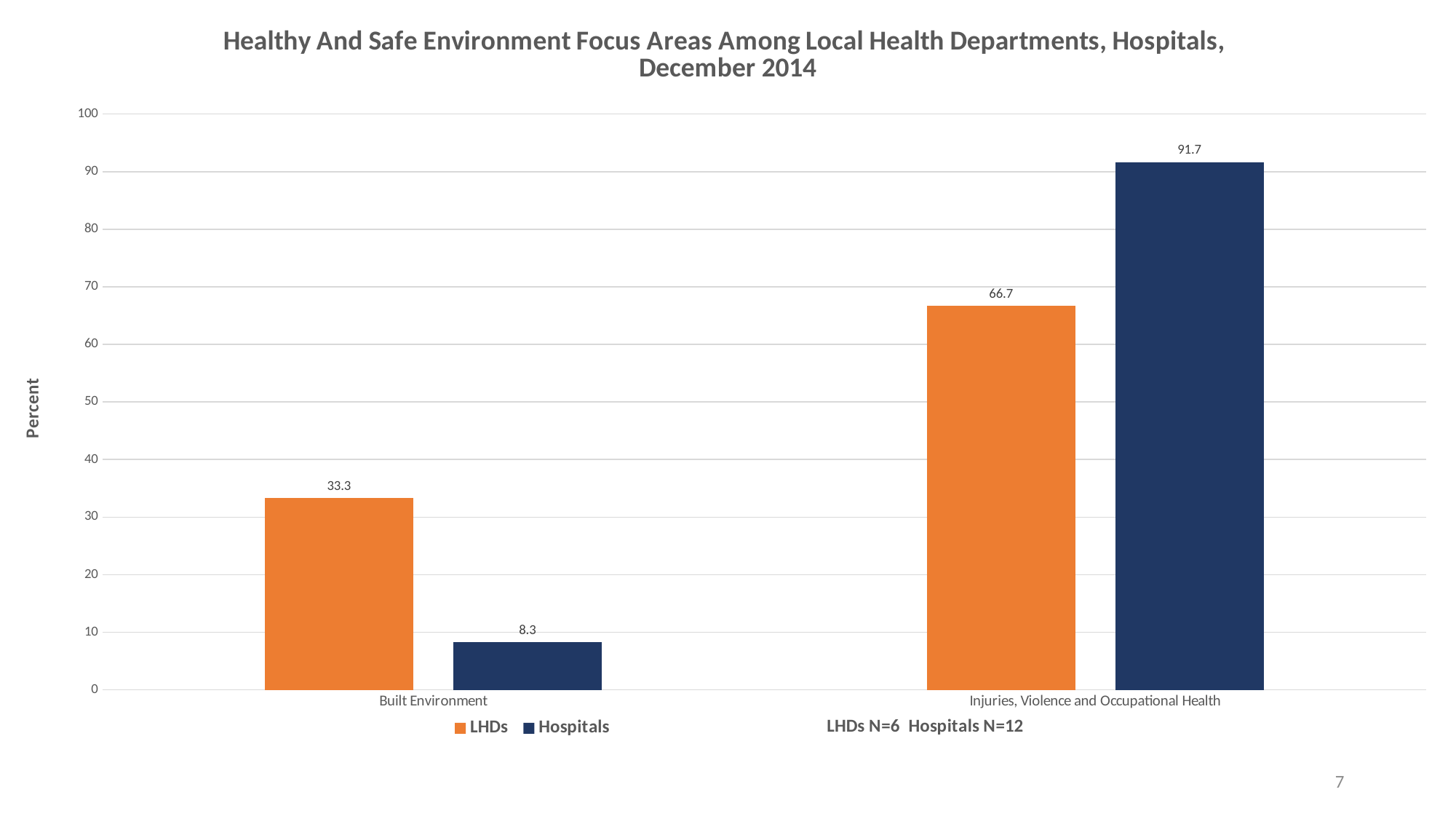
What is the difference between the LHDs and Hospitals values for Built Environment? 25 What is the difference between the Hospitals and LHDs values for Injuries, Violence and Occupational Health? 25 What is the value for LHDs in the Built Environment category? 33.3 How many categories are shown on the x axis? 2 What is the value for Hospitals in the Built Environment category? 8.3 Which bar has the lowest value on the chart? Hospitals, Built Environment What kind of chart is shown on the slide? Bar chart Which bar has the highest value on the chart? Hospitals, Injuries, Violence and Occupational Health What is the value for Hospitals in the Injuries, Violence and Occupational Health category? 91.7 What is the value for LHDs in the Injuries, Violence and Occupational Health category? 66.7 Which is larger for Built Environment: LHDs or Hospitals? LHDs How many series does the legend list? 2